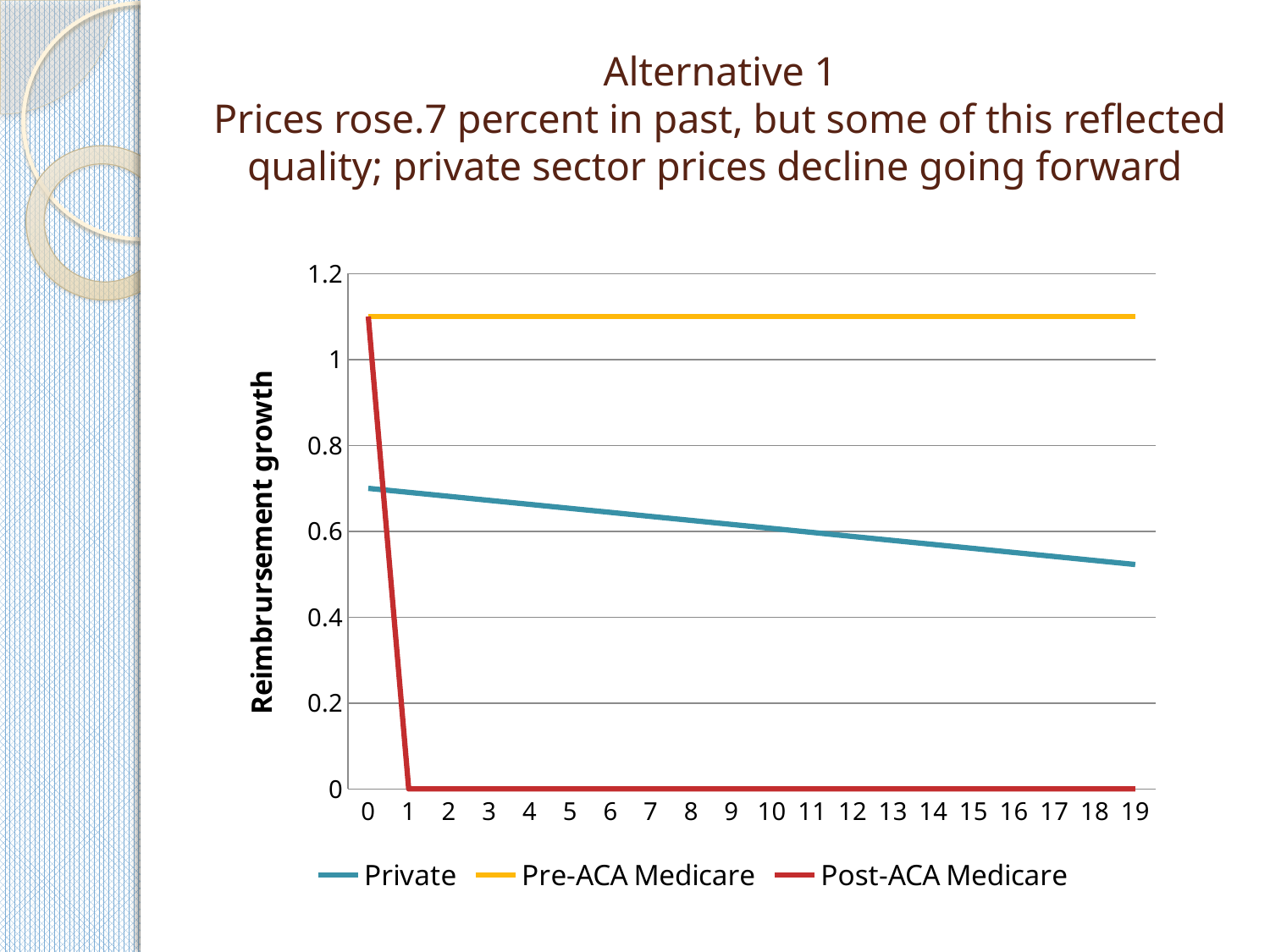
How many series does the legend list? 3 Does the Pre-ACA Medicare series rise, fall, or stay flat along the x axis? stay flat Which series has the lowest value at x = 19? Post-ACA Medicare Does the Private series rise or fall along the x axis? fall Is the value for Private at x = 19 greater or less than 0.6? less How many points are labelled along the x axis? 20 Is the value for Pre-ACA Medicare at x = 5 greater or less than 1? greater What is the value of Post-ACA Medicare at x = 10? 0 What kind of chart is shown on the slide? line chart What is the label on the y axis? Reimbrursement growth Is the value for Private at x = 0 greater or less than 0.6? greater Which series has the highest value at x = 19? Pre-ACA Medicare